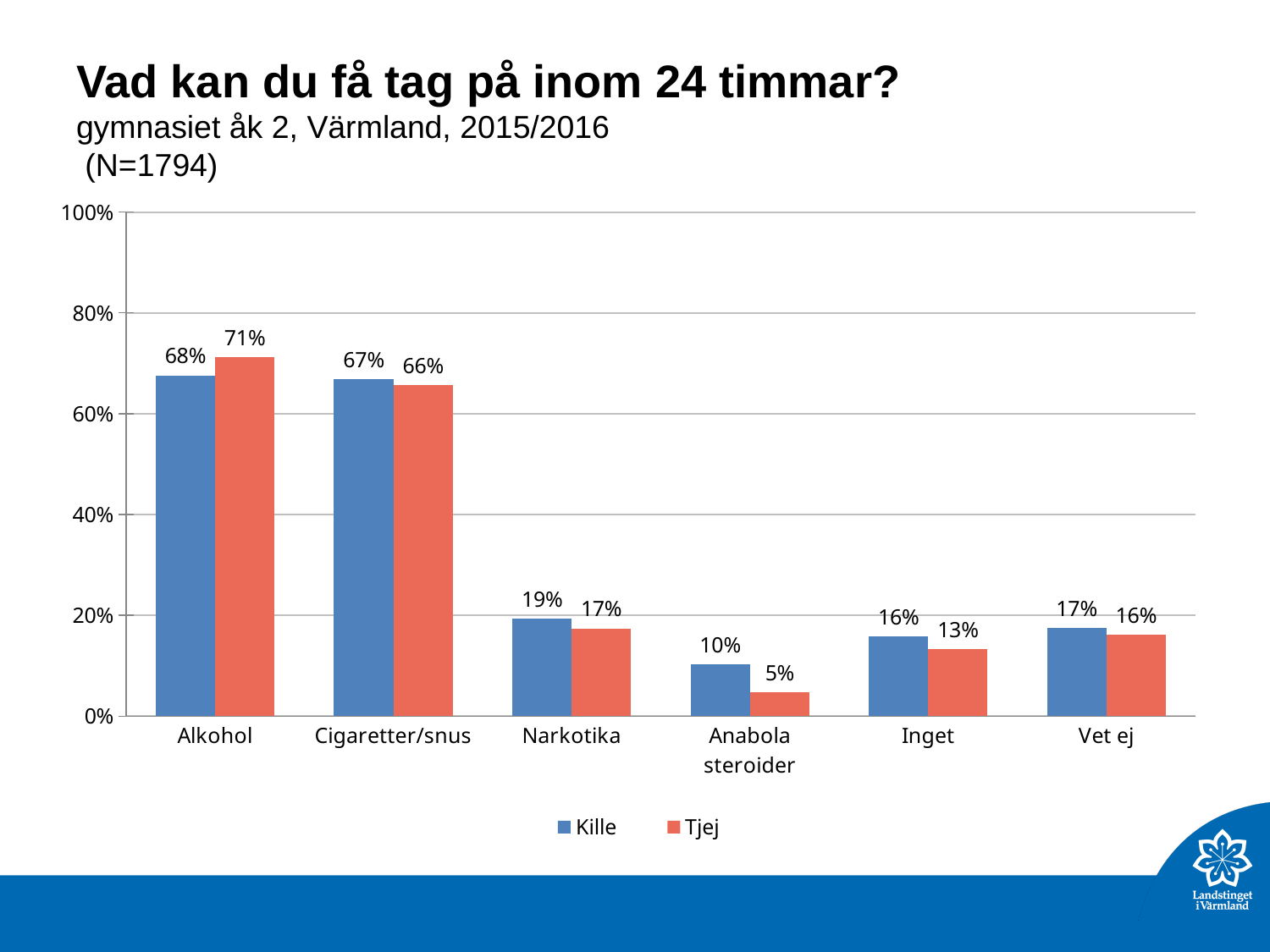
How many series does the legend list? 2 Which is larger, the Kille value for Narkotika or the Kille value for Vet ej? Narkotika What is the difference between the Kille and Tjej values for Anabola steroider? 5% Is the Tjej value for Cigaretter/snus greater or less than 60%? greater What is the value for Tjej in the Anabola steroider category? 5% Which category has the highest value for Tjej? Alkohol How many categories are shown on the x axis? 6 What is the value for Tjej in the Inget category? 13% What is the value for Kille in the Alkohol category? 68% What kind of chart is shown on the slide? Bar chart Which category has the lowest value for Kille? Anabola steroider What is the difference between the Kille values for Alkohol and Narkotika? 49%